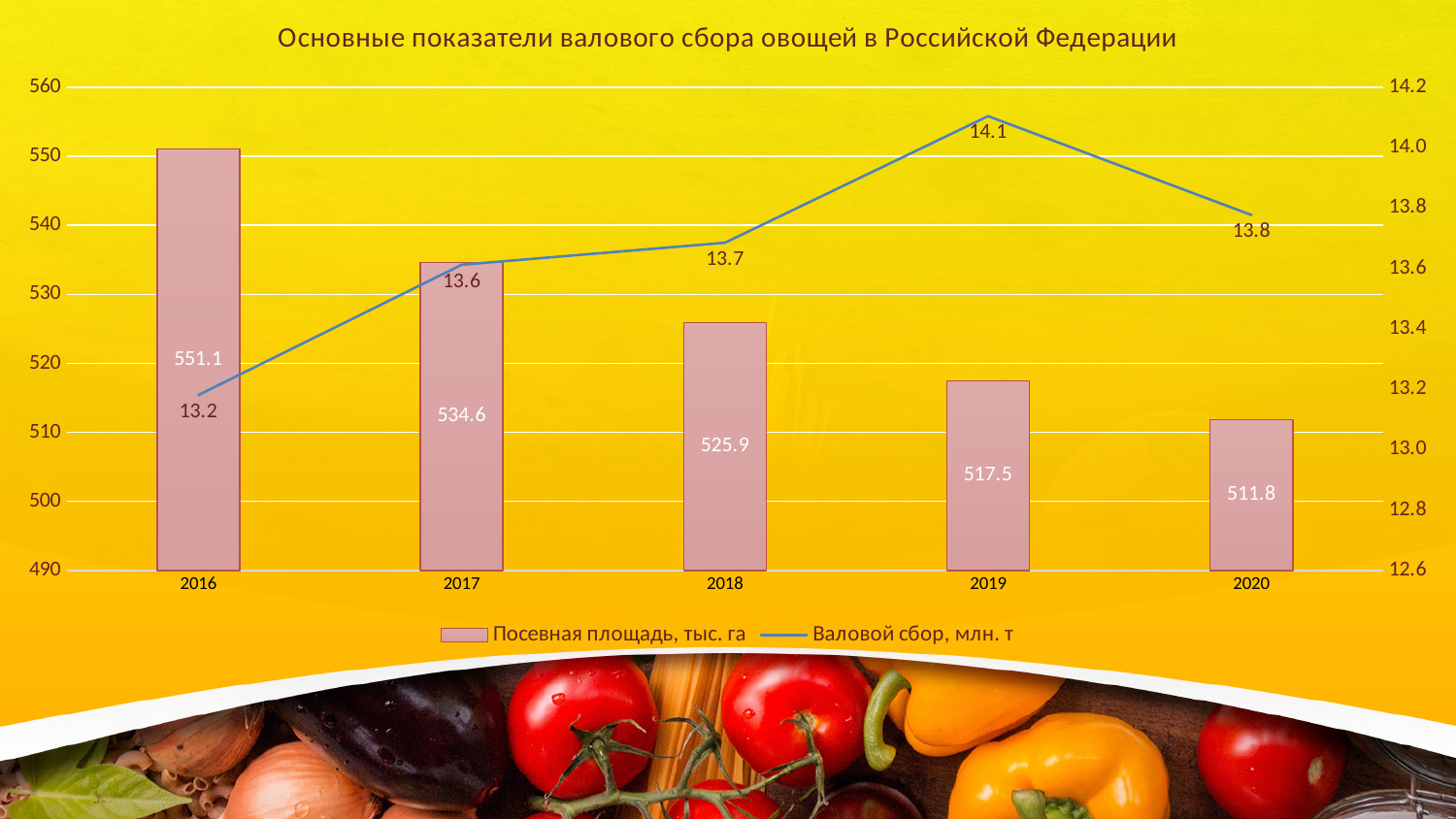
What is the sown area (Посевная площадь, тыс. га) in 2016? 551.1 How many years are shown on the x axis? 5 What is the gross harvest (Валовой сбор, млн. т) in 2019? 14.1 Which is larger: the gross harvest (Валовой сбор, млн. т) in 2018 or in 2020? 2020 What is the sown area (Посевная площадь, тыс. га) in 2020? 511.8 Which year has the lowest sown area (Посевная площадь, тыс. га)? 2020 Does the sown area (Посевная площадь, тыс. га) rise or fall from 2016 to 2020? Fall Which year has the highest gross harvest (Валовой сбор, млн. т)? 2019 How many series does the legend list? 2 What is the difference in sown area (Посевная площадь, тыс. га) between 2016 and 2020? 39.3 What kind of chart is shown on the slide? Combined bar and line chart What is the title of the chart? Основные показатели валового сбора овощей в Российской Федерации